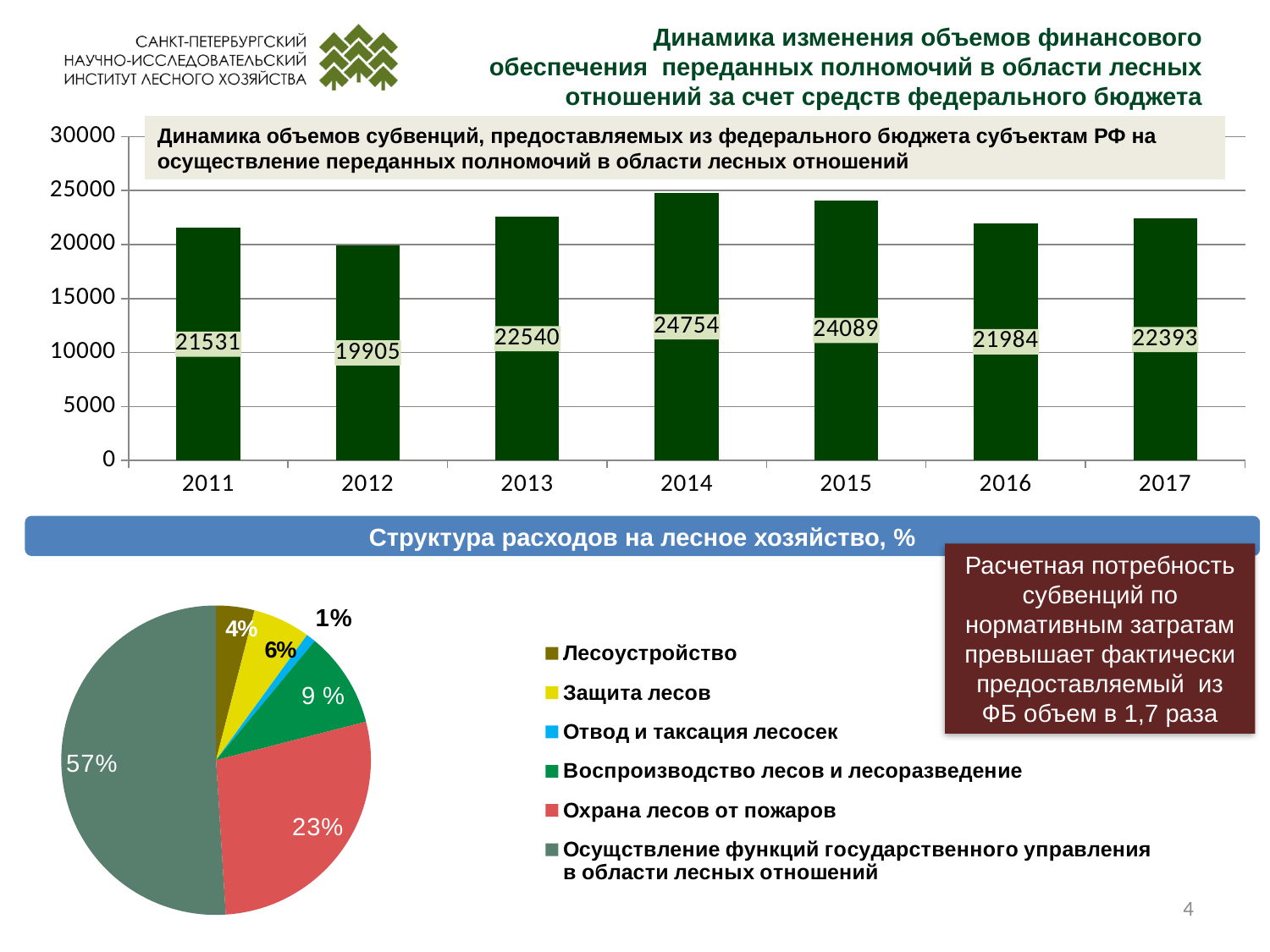
In the top bar chart, what is the value for 2012? 19905 What kind of chart is the top chart on the slide? bar chart In the top bar chart, which year has the lowest value? 2012 In the top bar chart, what is the value for 2014? 24754 In the pie chart 'Структура расходов на лесное хозяйство, %', which category has the smallest share? Отвод и таксация лесосек How many categories does the legend of the pie chart 'Структура расходов на лесное хозяйство, %' list? 6 In the pie chart 'Структура расходов на лесное хозяйство, %', which category has the largest share? Осущствление функций государственного управления в области лесных отношений In the pie chart 'Структура расходов на лесное хозяйство, %', what share is 'Охрана лесов от пожаров'? 23% In the top bar chart, which year has the highest value? 2014 In the top bar chart, what is the difference between the values for 2014 and 2015? 665 In the top bar chart, which is larger, the value for 2013 or the value for 2017? 2013 How many years are shown in the top bar chart? 7